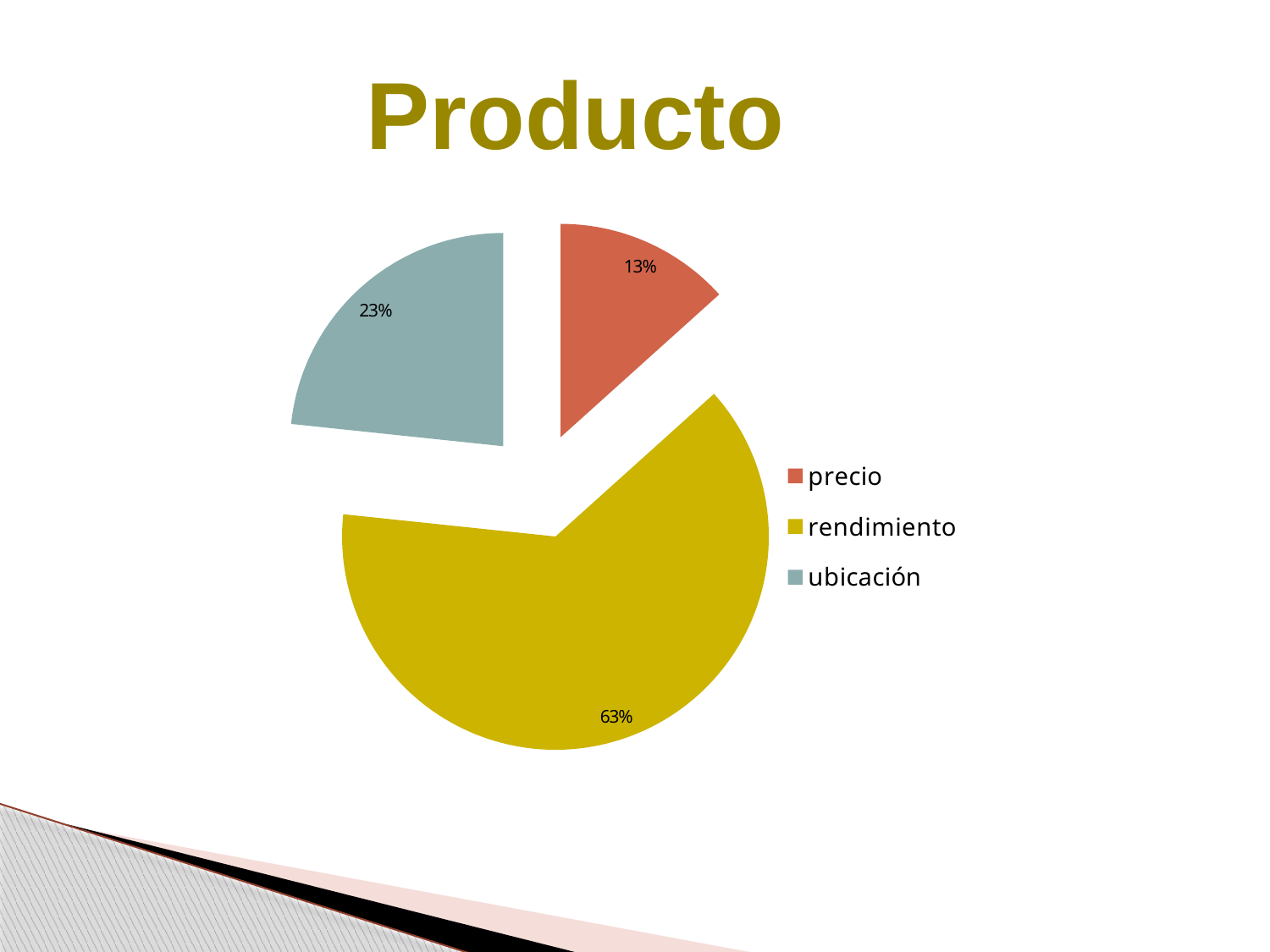
What percentage share does the rendimiento slice have? 63% Which slice is larger, precio or ubicación? ubicación How many slices does the pie chart have? 3 Which colour represents rendimiento in the legend? yellow What percentage share does the precio slice have? 13% What kind of chart is shown on the slide? pie chart Which category has the largest slice of the pie? rendimiento What is the difference in percentage points between the rendimiento and ubicación slices? 40 What is the difference in percentage points between the ubicación and precio slices? 10 What percentage share does the ubicación slice have? 23% Which category has the smallest slice of the pie? precio What is the title of the slide containing the pie chart? Producto